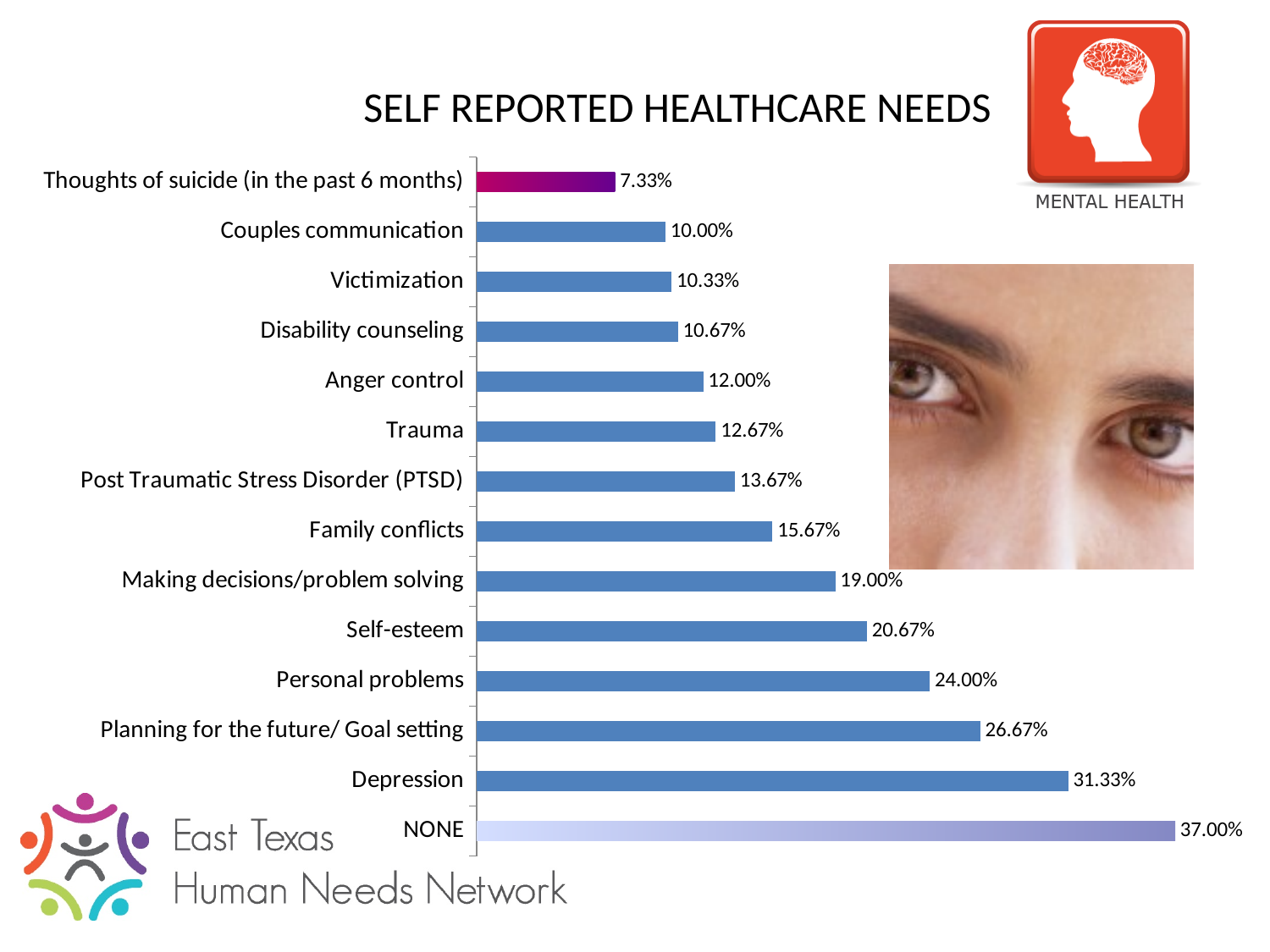
What kind of chart is shown on the slide? Bar chart Which category has the lowest value? Thoughts of suicide (in the past 6 months) How many categories are shown in the chart? 14 What is the value for Thoughts of suicide (in the past 6 months)? 7.33% What is the value for Self-esteem? 20.67% What is the difference between the values for NONE and Depression? 5.67% What is the difference between the values for Personal problems and Anger control? 12.00% What is the value for Depression? 31.33% What is the value for Post Traumatic Stress Disorder (PTSD)? 13.67% Which category has the highest value? NONE Which is larger, the value for Family conflicts or the value for Trauma? Family conflicts What is the title of the chart? SELF REPORTED HEALTHCARE NEEDS